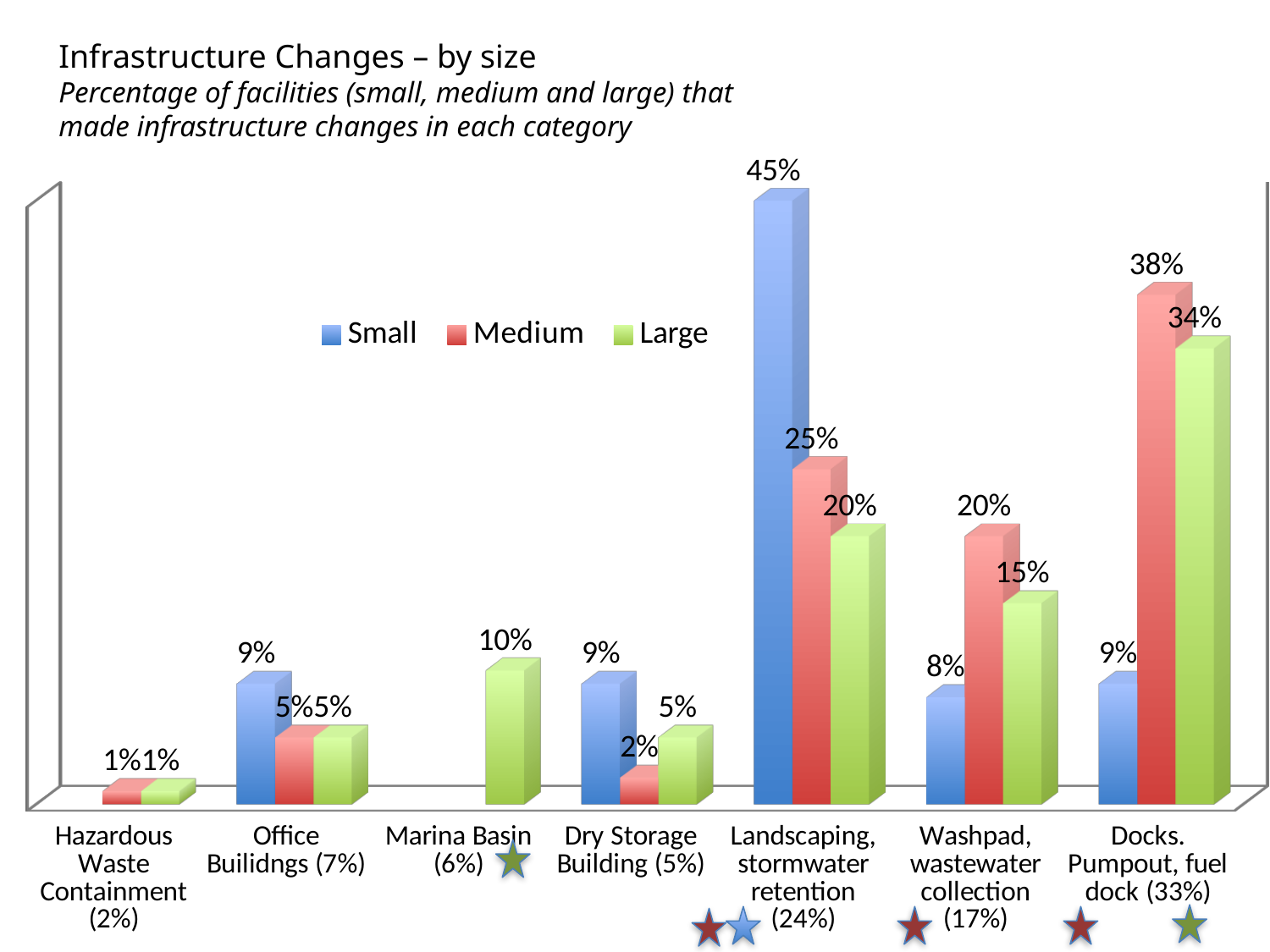
How many series does the legend list? 3 What is the difference between the Medium and Large values in the Docks. Pumpout, fuel dock category? 4 percentage points What is the value for Medium in the Docks. Pumpout, fuel dock category? 38% How many categories are shown on the x axis? 7 In the Washpad, wastewater collection category, which is larger: the Medium value or the Large value? Medium Which category has the highest value for the Medium series? Docks. Pumpout, fuel dock What is the value for Small in the Landscaping, stormwater retention category? 45% What is the difference between the Small and Medium values in the Landscaping, stormwater retention category? 20 percentage points What is the value for Large in the Marina Basin category? 10% What kind of chart is shown on the slide? Bar chart What is the value for Medium in the Dry Storage Building category? 2% Which category has the highest value for the Small series? Landscaping, stormwater retention